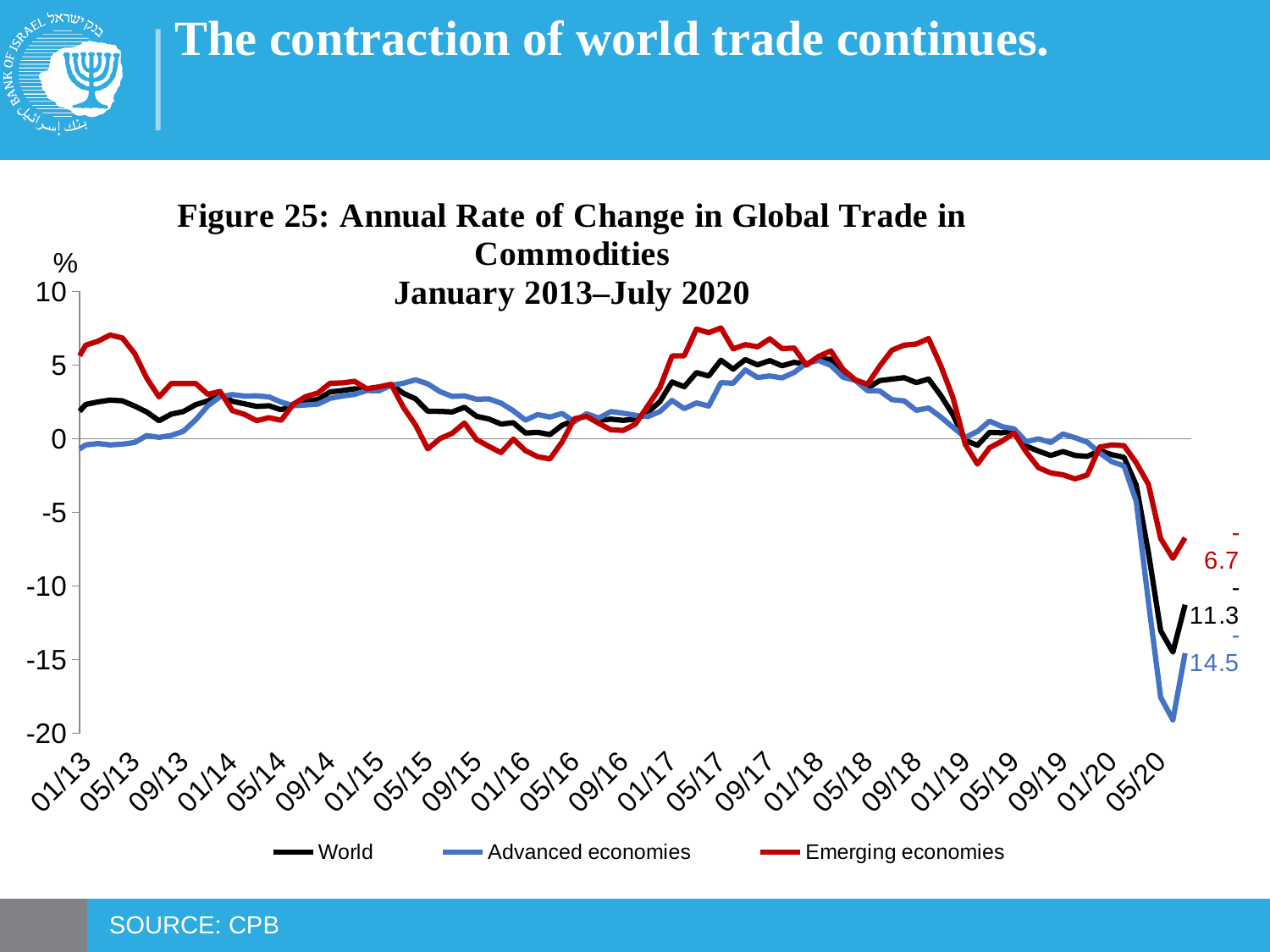
Which series has the lowest labelled value at the end of the chart? Advanced economies What is the final labelled value for the Advanced economies series? -14.5 What is the difference between the final labelled values of the World and Advanced economies series? 3.2 Is the lowest point of the Advanced economies line in 2020 greater or less than -15? less At the end of the chart, which is larger: the labelled value for Emerging economies or for Advanced economies? Emerging economies How many series does the legend list? 3 Which series has the highest labelled value at the end of the chart? Emerging economies Is the value for Emerging economies around 05/13 greater or less than 5? greater What is the final labelled value for the Emerging economies series? -6.7 What kind of chart is shown on the slide? Line chart Do the values rise or fall between 01/20 and 05/20? Fall What is the final labelled value for the World series at the end of the chart? -11.3